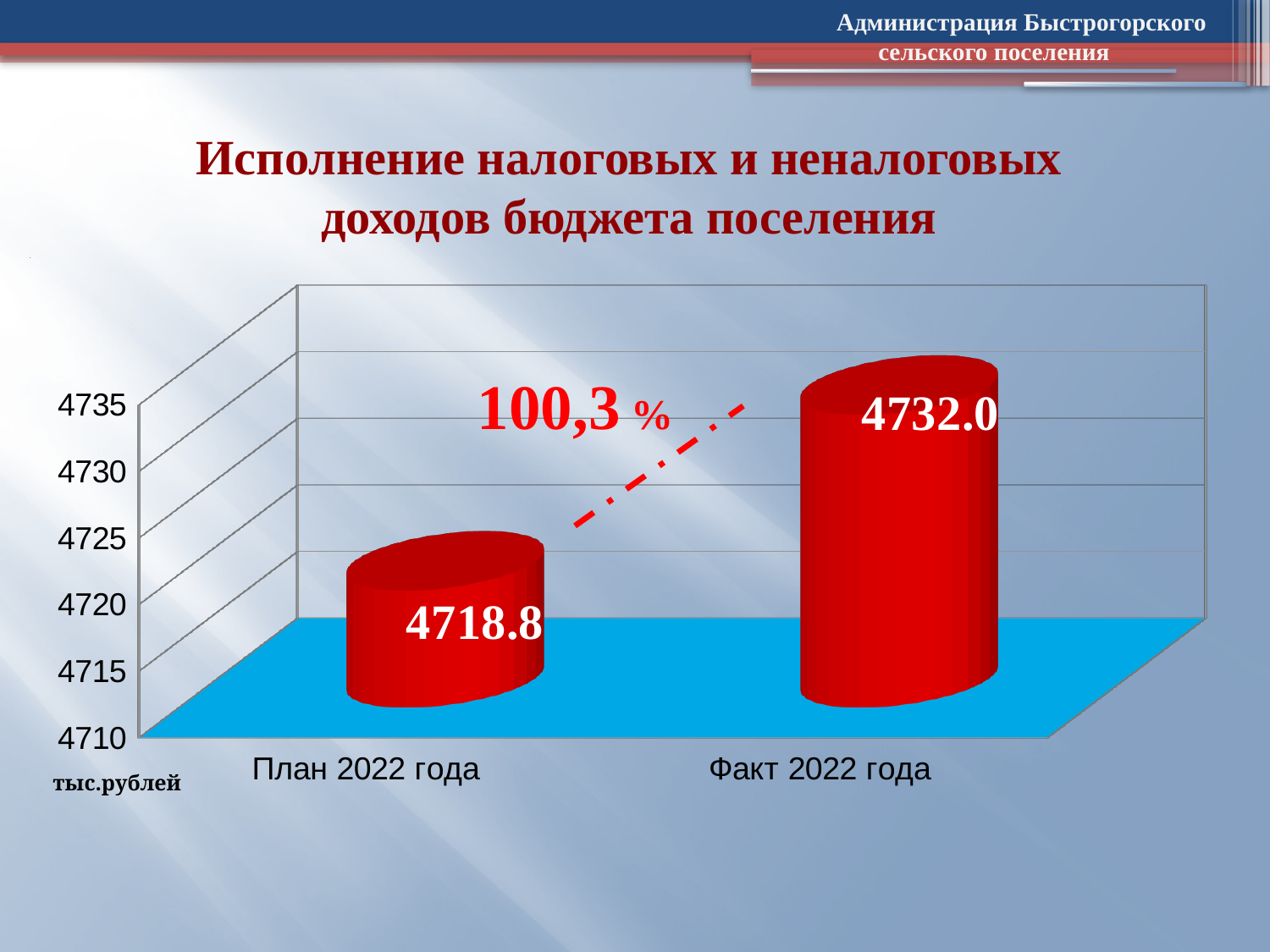
What is the value for План 2022 года? 4718.8 Which category has the highest value? Факт 2022 года Which category has the lowest value? План 2022 года Is the value for План 2022 года greater or less than 4720? less What is the value for Факт 2022 года? 4732.0 How many categories are shown on the x axis? 2 What is the difference between the values for Факт 2022 года and План 2022 года? 13.2 What unit is indicated below the y axis of the chart? тыс.рублей Is the value for Факт 2022 года greater or less than 4730? greater What kind of chart is shown on the slide? bar chart Which is larger, the value for План 2022 года or the value for Факт 2022 года? Факт 2022 года What percentage is printed above the bars on the chart? 100,3 %